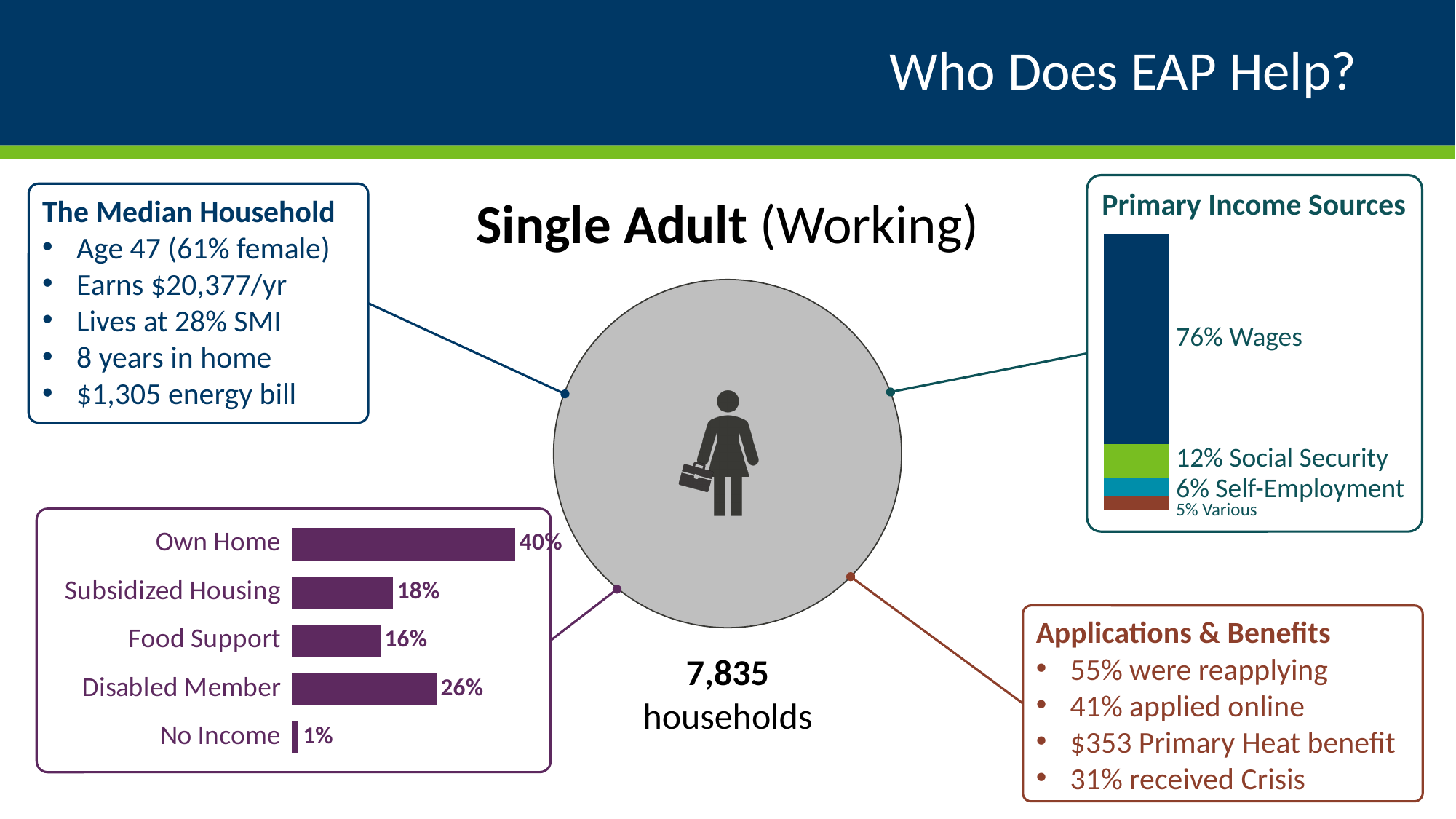
In the bar chart at the bottom left of the slide, what is the value for Own Home? 40% In the Primary Income Sources chart, what share is Wages? 76% How many categories are shown in the bar chart at the bottom left of the slide? 5 In the bar chart at the bottom left of the slide, which category has the lowest value? No Income In the bar chart at the bottom left of the slide, what is the value for Food Support? 16% In the bar chart at the bottom left of the slide, which is larger: Subsidized Housing or Disabled Member? Disabled Member In the Primary Income Sources chart, what is the difference between Social Security and Self-Employment? 6% In the bar chart at the bottom left of the slide, what is the difference between Own Home and Subsidized Housing? 22% In the bar chart at the bottom left of the slide, which category has the highest value? Own Home How many segments does the Primary Income Sources stacked bar have? 4 What kind of chart is the one at the bottom left of the slide? Bar chart In the bar chart at the bottom left of the slide, what is the value for Disabled Member? 26%